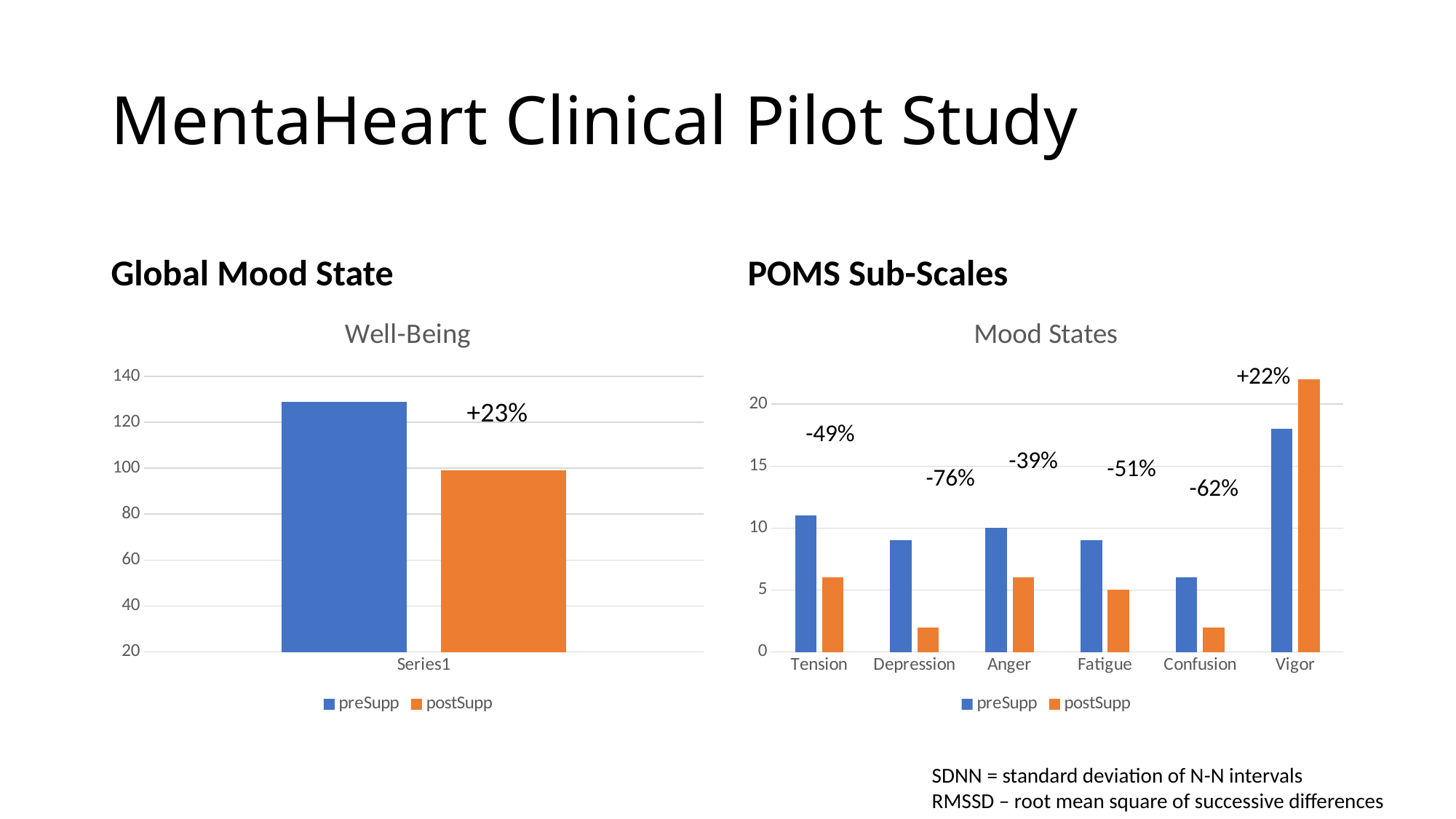
In the Well-Being chart, is the preSupp value greater or less than 120? greater What percentage change is annotated on the Well-Being chart? +23% In the Mood States chart, how many mood categories are shown on the x axis? 6 In the Mood States chart, what percentage change is annotated above Depression? -76% In the Mood States chart, is the postSupp value for Depression greater or less than 5? less In the Well-Being chart, is the postSupp value greater or less than 80? greater What kind of chart is the Well-Being chart on the left? bar chart In the Mood States chart, which category has the highest postSupp bar? Vigor In the Well-Being chart, how many series does the legend list? 2 In the Well-Being chart, which series has the larger value, preSupp or postSupp? preSupp In the Mood States chart, which category has the lowest preSupp bar? Confusion